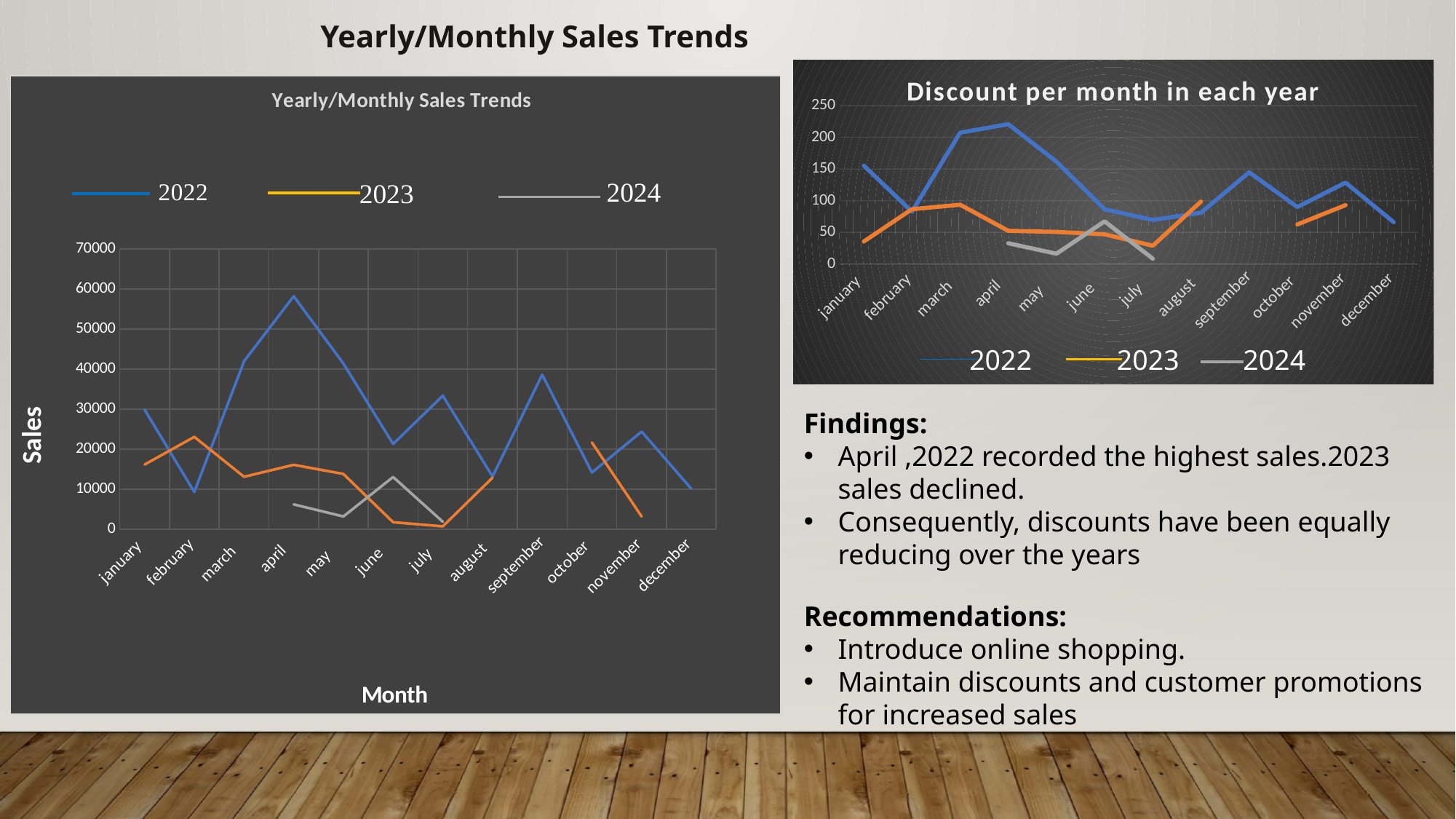
On the Yearly/Monthly Sales Trends chart, what kind of chart is it? line chart On the Yearly/Monthly Sales Trends chart, is the 2024 value for june greater or less than 10000? greater On the Discount per month in each year chart, in which month does the 2024 series reach its lowest value? july On the Yearly/Monthly Sales Trends chart, which is larger in april: the 2022 value or the 2023 value? 2022 On the Yearly/Monthly Sales Trends chart, how many months are shown on the x axis? 12 On the Discount per month in each year chart, is the 2022 value for april greater or less than 200? greater On the Discount per month in each year chart, in which month does the 2022 series reach its highest value? april On the Discount per month in each year chart, which is larger in january: the 2022 value or the 2023 value? 2022 On the Yearly/Monthly Sales Trends chart, how many series does the legend list? 3 On the Yearly/Monthly Sales Trends chart, in which month does the 2023 series reach its lowest value? july On the Yearly/Monthly Sales Trends chart, in which month does the 2022 series reach its highest value? april On the Yearly/Monthly Sales Trends chart, is the 2022 value for april greater or less than 50000? greater